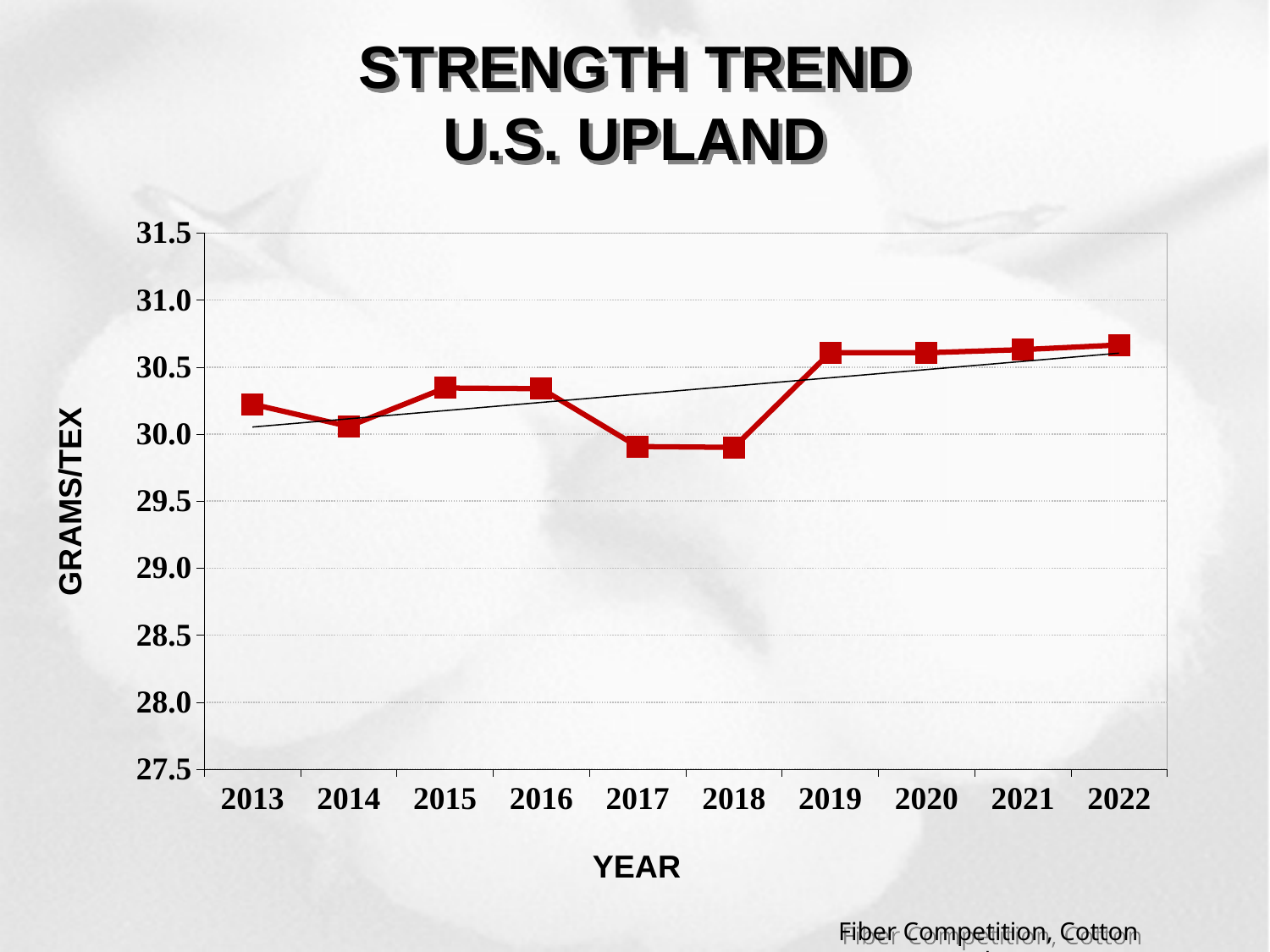
What is the title of the chart? STRENGTH TREND U.S. UPLAND Which year has the larger value, 2014 or 2019? 2019 Does the overall trend of strength from 2013 to 2022 rise or fall? rise What is the label on the y axis? GRAMS/TEX Is the value for 2015 greater or less than 30.5? less Is the value for 2017 greater or less than 30.0? less Is the value for 2019 greater or less than 30.5? greater How many years are plotted on the x axis? 10 What kind of chart is shown on the slide? line chart Which year has the larger value, 2015 or 2017? 2015